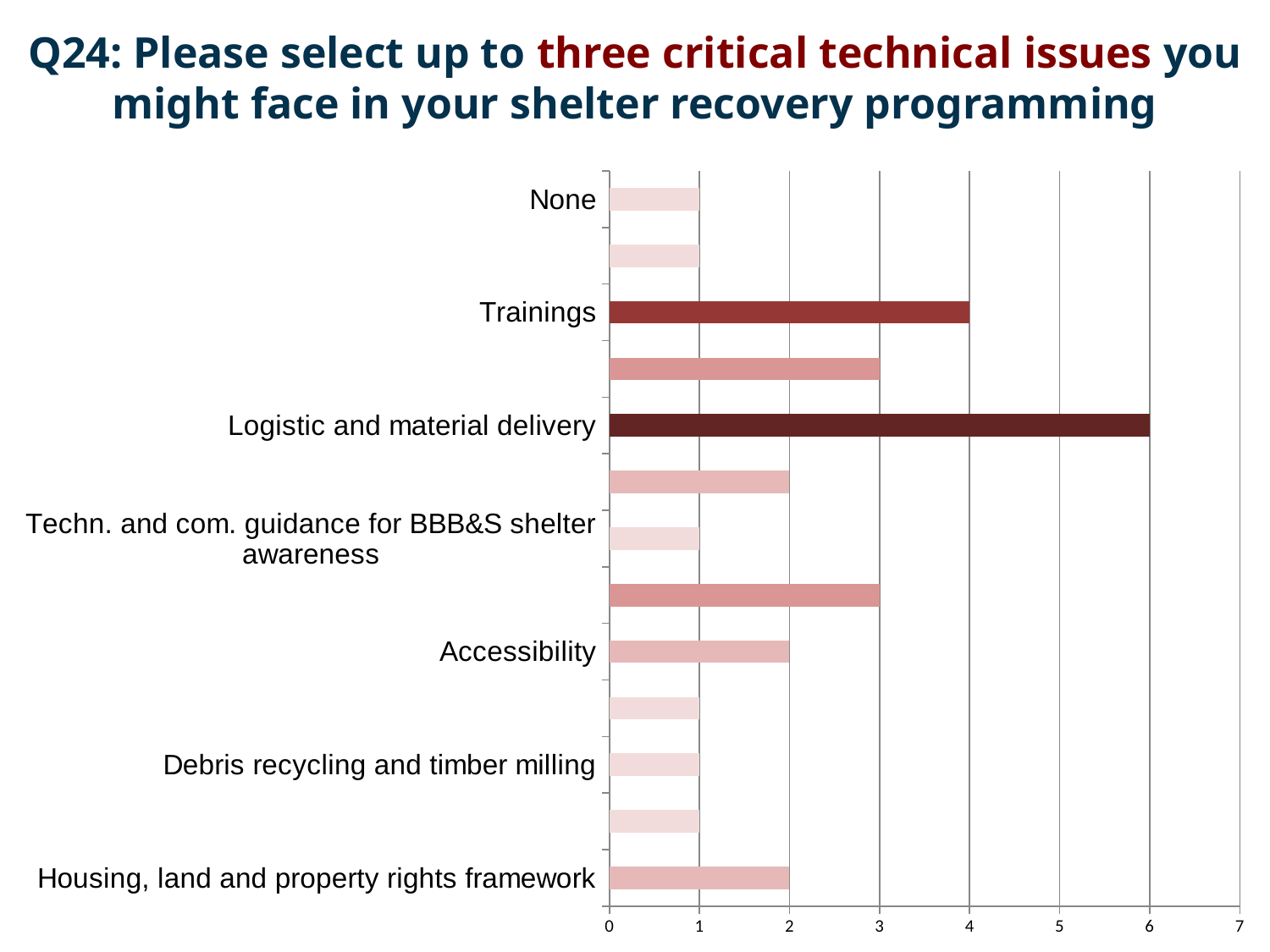
What is the highest value shown on the horizontal axis? 7 What is the difference between the values for Logistic and material delivery and Trainings? 2 What is the value for None? 1 What is the value for Debris recycling and timber milling? 1 Which is larger, the value for Trainings or the value for Accessibility? Trainings What is the value for Trainings? 4 What is the value for Accessibility? 2 What is the value for Logistic and material delivery? 6 What kind of chart is shown on the slide? bar chart What is the value for Housing, land and property rights framework? 2 Is the value for Logistic and material delivery greater or less than 5? greater Which labelled category has the highest value? Logistic and material delivery